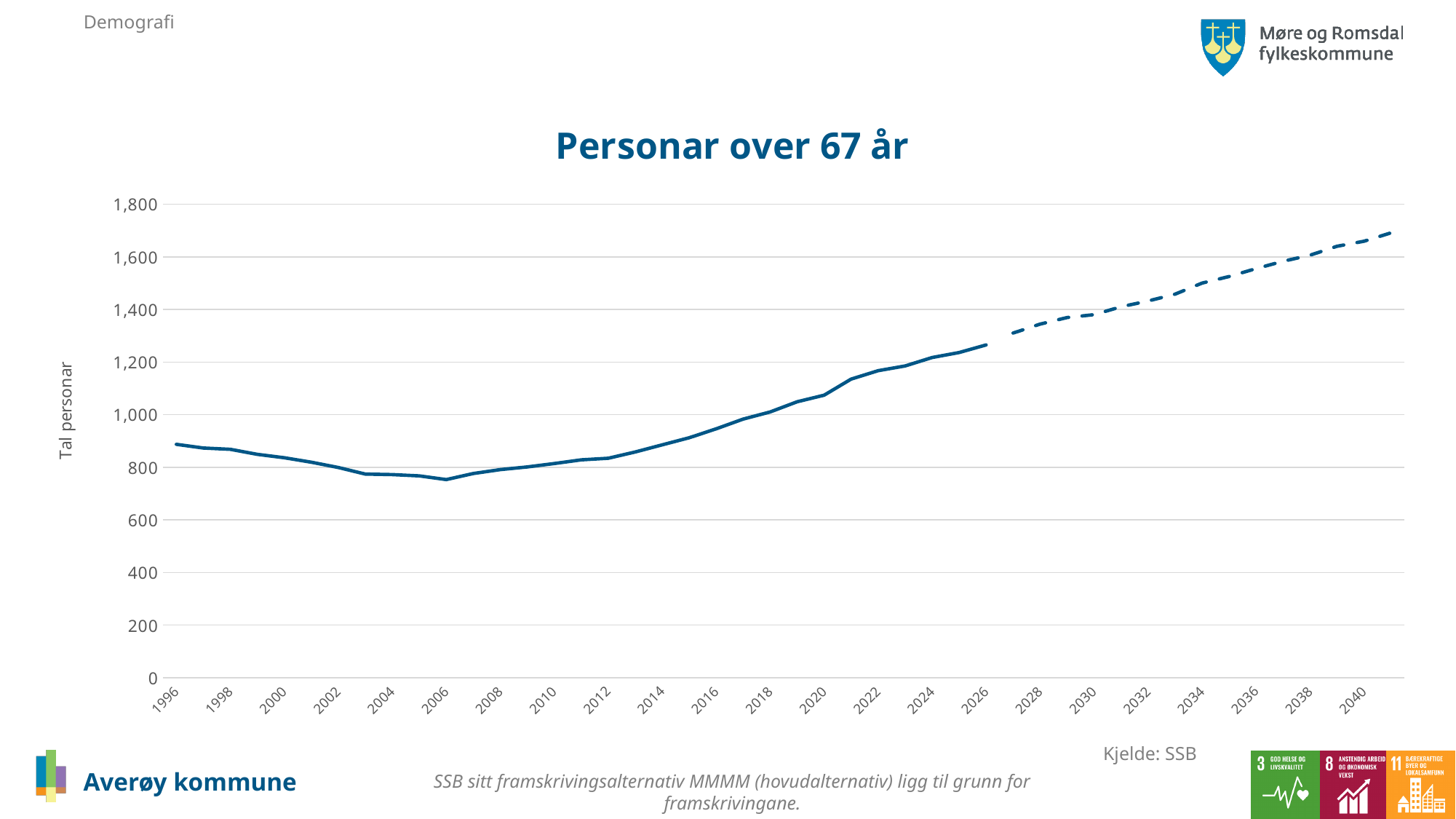
What is the title of the chart? Personar over 67 år What kind of chart is shown on the slide? line chart Is the value for 1996 greater or less than 800? greater Is the value for 2020 greater or less than 1,000? greater Is the value for 2006 greater or less than 800? less Which year has the larger value, 1996 or 2006? 1996 In which year does the line reach its lowest value? 2006 What is the label on the vertical axis of the chart? Tal personar Does the line rise or fall between 2006 and 2040? rise